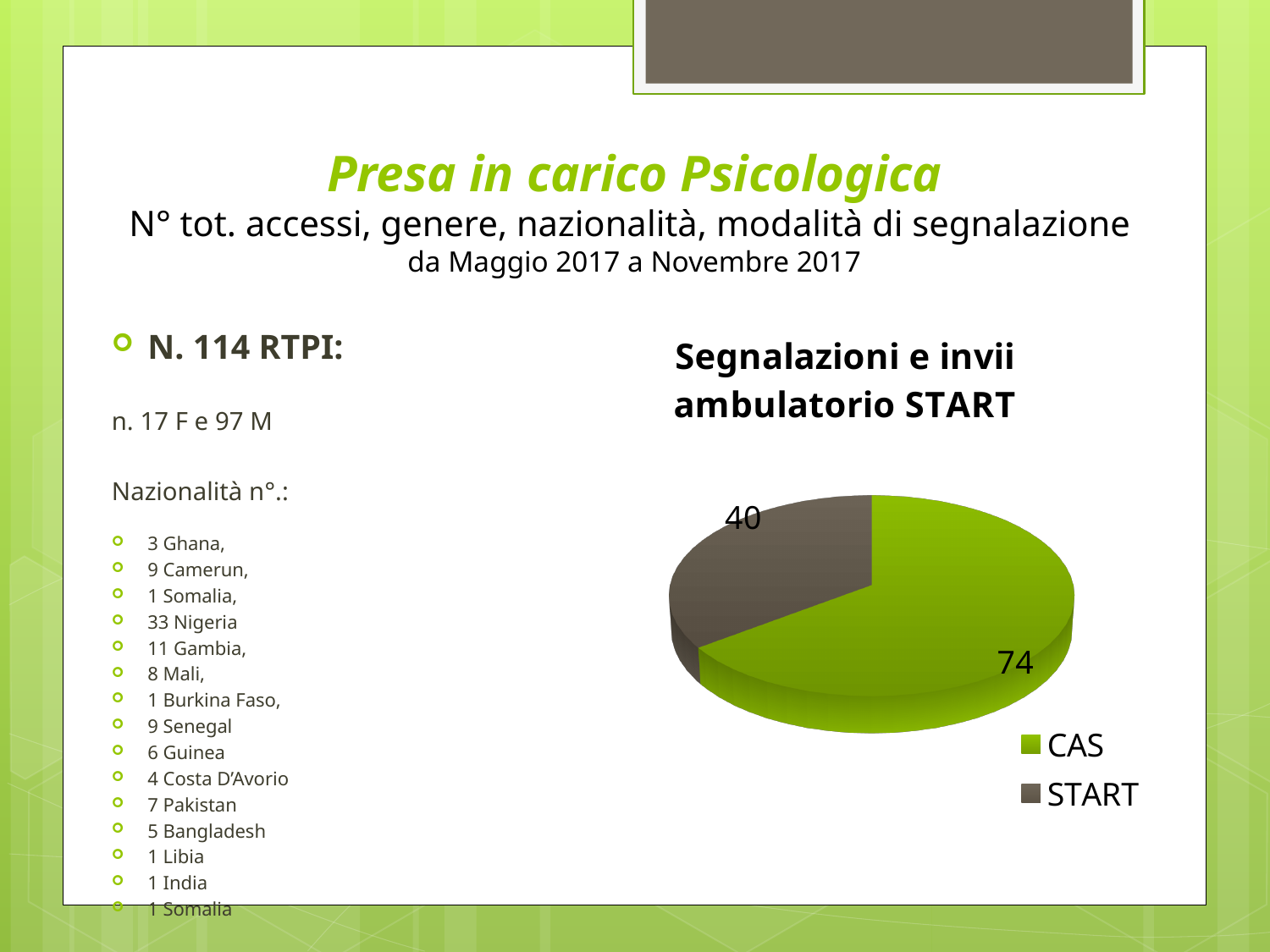
What is the total of the two values shown in the pie chart? 114 What is the value for START in the pie chart? 40 What type of chart is shown on the slide? Pie chart What is the value for CAS in the pie chart? 74 What is the title of the pie chart? Segnalazioni e invii ambulatorio START How many slices does the pie chart have? 2 Which slice of the pie chart is the smallest? START How many entries does the pie chart legend list? 2 Which is larger in the pie chart, CAS or START? CAS What is the difference between the CAS and START values in the pie chart? 34 Which slice of the pie chart is the largest? CAS What fraction of the pie chart total does CAS represent? 74 out of 114